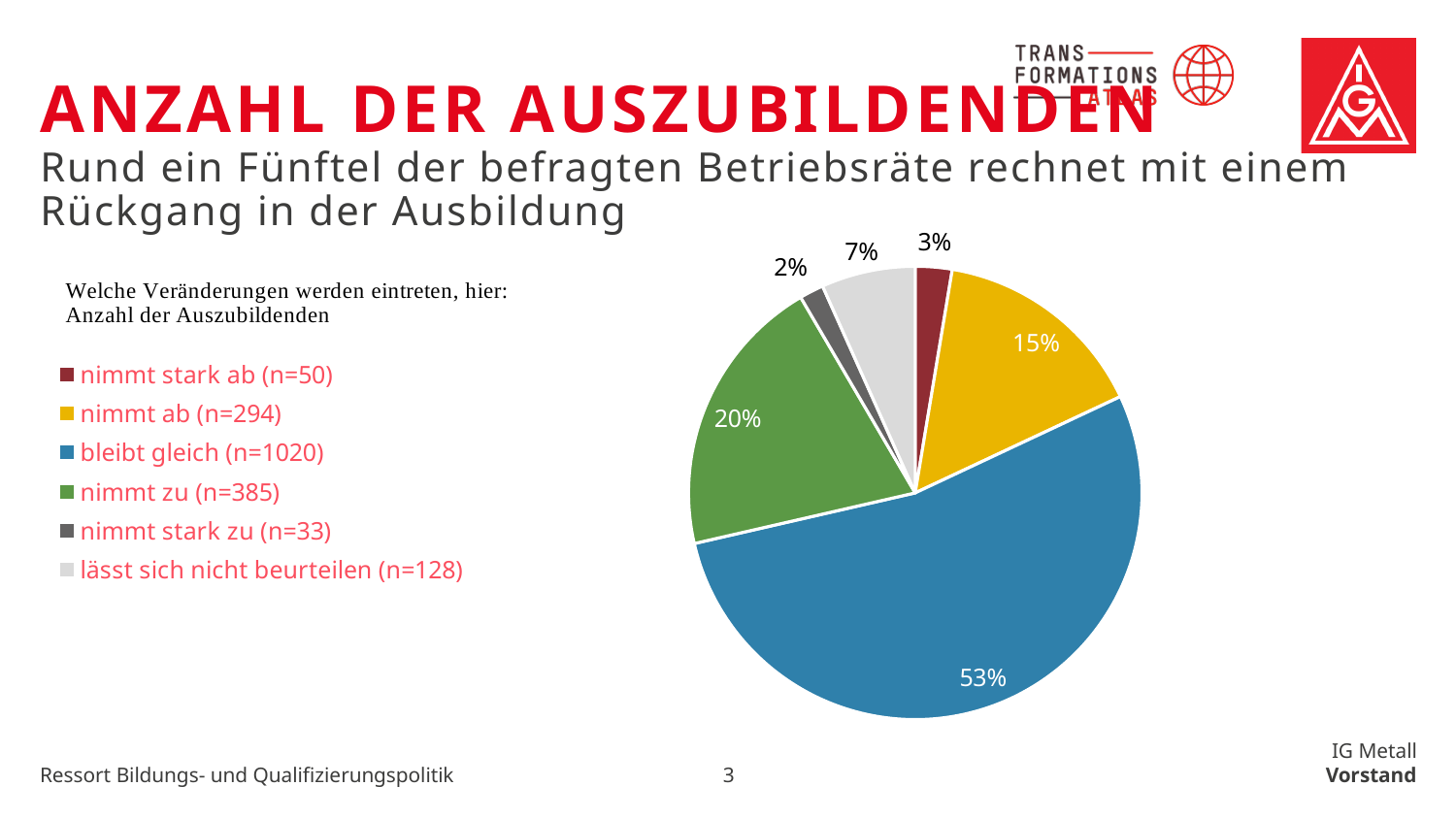
Which category has the smallest slice of the pie? nimmt stark zu (n=33) What kind of chart is shown on the slide? pie chart How many categories does the pie chart have? 6 What share of the pie does "bleibt gleich (n=1020)" have? 53% Which category has the largest slice of the pie? bleibt gleich (n=1020) What colour is the slice for "nimmt zu (n=385)"? green What share of the pie does "lässt sich nicht beurteilen (n=128)" have? 7% What share of the pie does "nimmt stark ab (n=50)" have? 3% Which is larger, the slice for "nimmt ab (n=294)" or the slice for "lässt sich nicht beurteilen (n=128)"? nimmt ab (n=294) What is the difference in percentage points between "nimmt zu (n=385)" and "nimmt ab (n=294)"? 5 percentage points